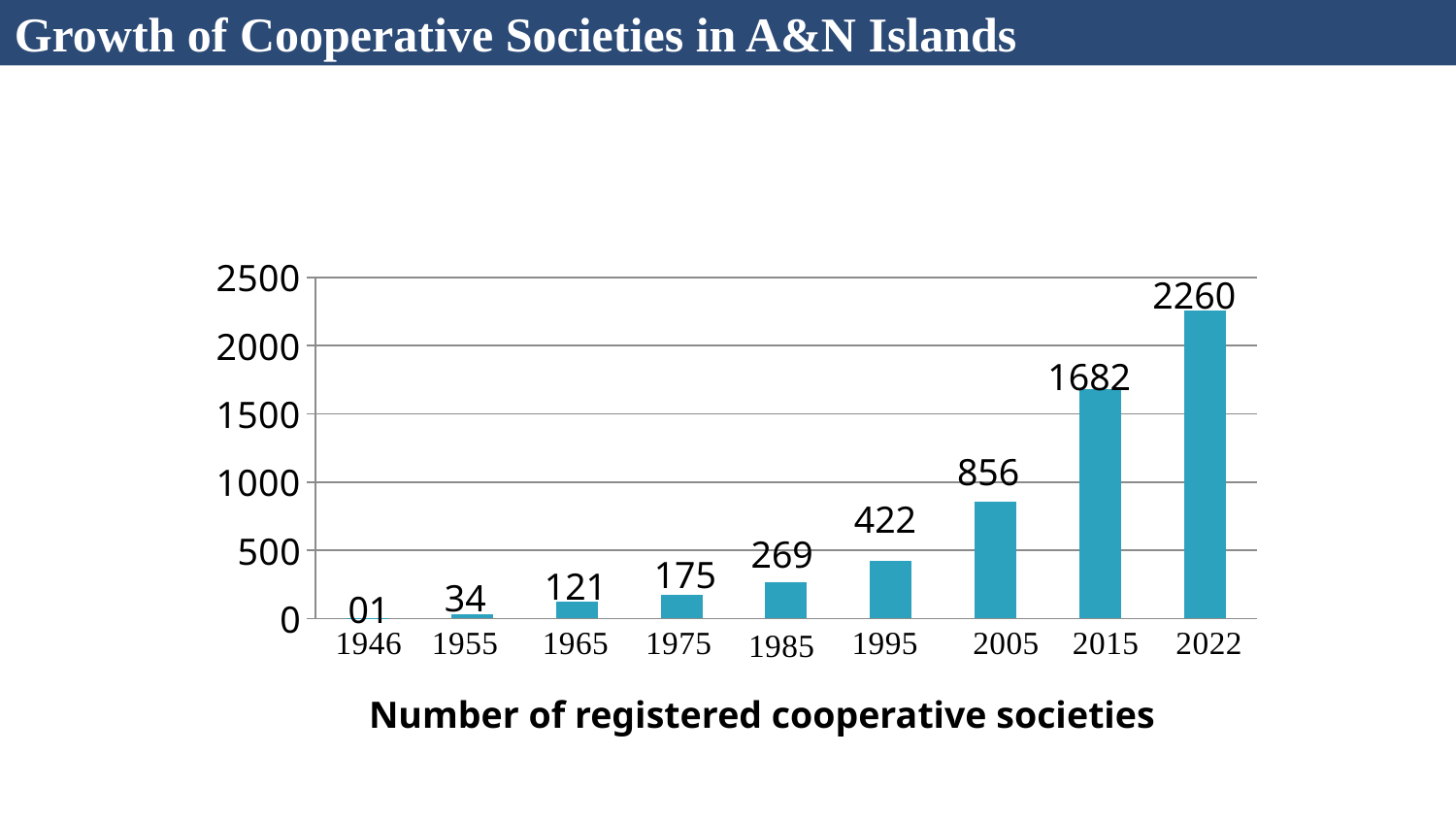
How many years are shown on the x axis of the chart? 9 Which year has the highest number of registered cooperative societies? 2022 What is the number of registered cooperative societies in 1985? 269 What is the number of registered cooperative societies in 1965? 121 What type of chart is shown on the slide? Bar chart What is the number of registered cooperative societies in 2005? 856 Does the number of registered cooperative societies rise or fall from 1946 to 2022? Rise What is the difference in the number of registered cooperative societies between 2005 and 1995? 434 Is the number of registered cooperative societies in 2015 greater or less than 1500? greater Which year has more registered cooperative societies, 1975 or 1995? 1995 What is the number of registered cooperative societies in 2022? 2260 What is the difference in the number of registered cooperative societies between 2022 and 2015? 578